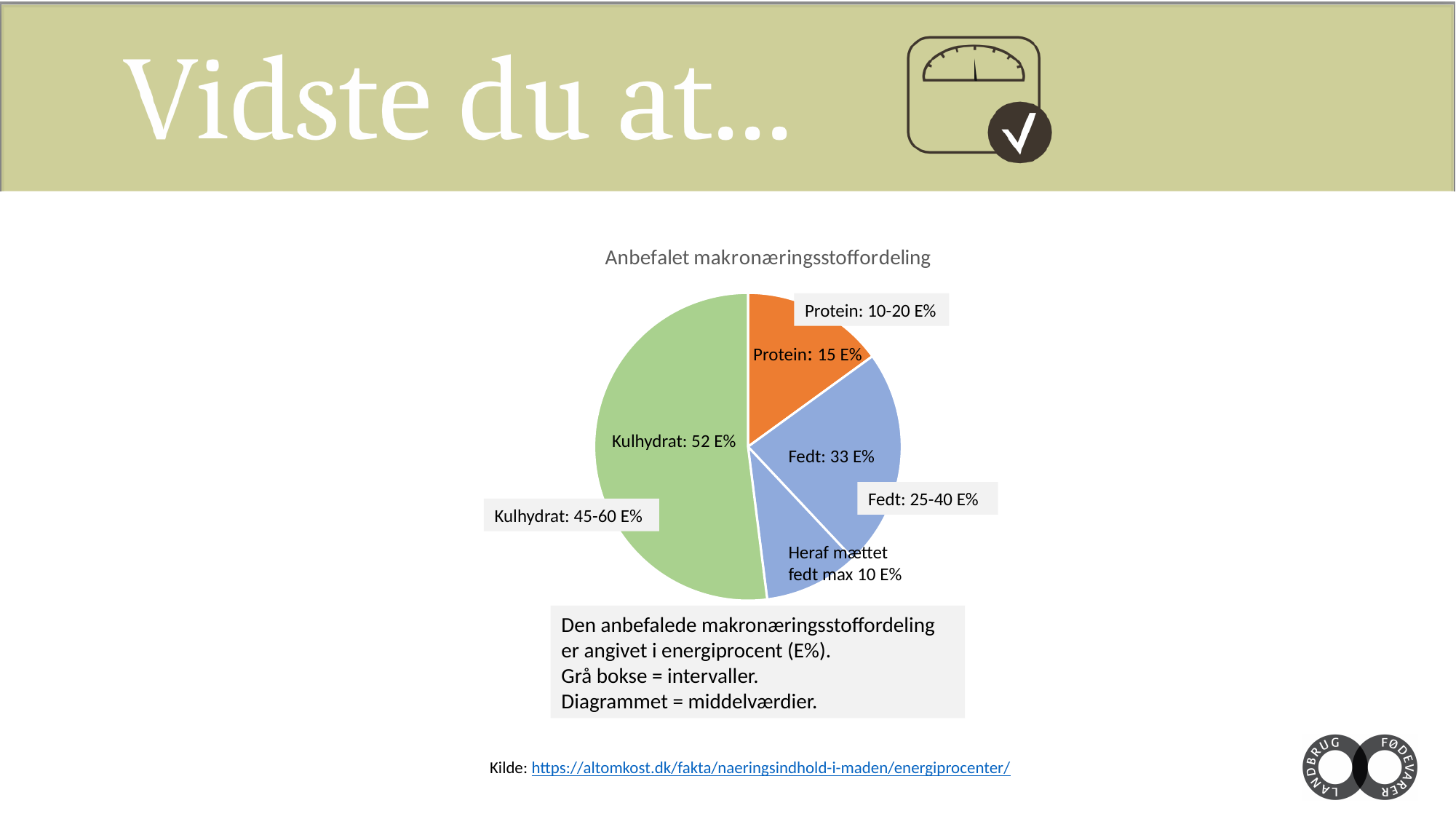
What is the title of the chart? Anbefalet makronæringsstoffordeling What type of chart is shown on the slide? pie chart Which macronutrient has the largest slice in the pie chart? Kulhydrat What value is shown for Protein in the pie chart? 15 E% What colour is the Kulhydrat slice in the pie chart? green What interval is given in the grey box for Fedt? 25-40 E% What value is shown for Fedt in the pie chart? 33 E% What is the difference between the Fedt and Protein values in the pie chart? 18 E% What is the difference between the Kulhydrat and Fedt values in the pie chart? 19 E% Which is larger in the pie chart, Fedt or Protein? Fedt What value is shown for Kulhydrat in the pie chart? 52 E%